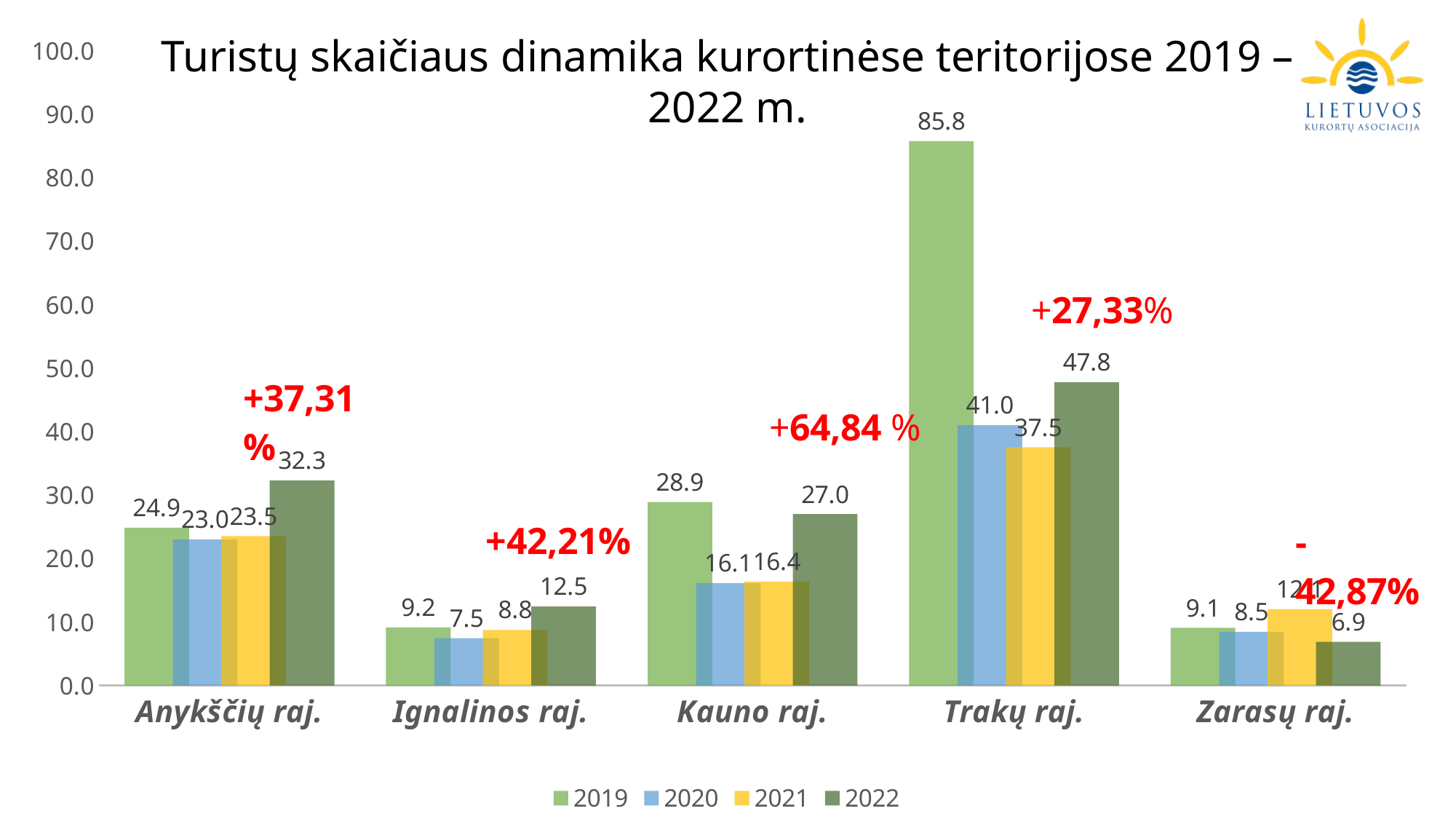
What is the 2020 value for Ignalinos raj.? 7.5 Which is larger for Kauno raj., the 2019 value or the 2022 value? 2019 How many series does the legend list? 4 What is the 2022 value for Anykščių raj.? 32.3 What is the 2019 value for Kauno raj.? 28.9 Which category has the highest 2019 value? Trakų raj. What is the 2022 value for Trakų raj.? 47.8 What is the title of the chart? Turistų skaičiaus dinamika kurortinėse teritorijose 2019 – 2022 m. How many categories are shown on the x axis? 5 Which category has the lowest 2022 value? Zarasų raj. What kind of chart is shown on the slide? Bar chart What is the difference between the 2019 and 2022 values for Trakų raj.? 38.0